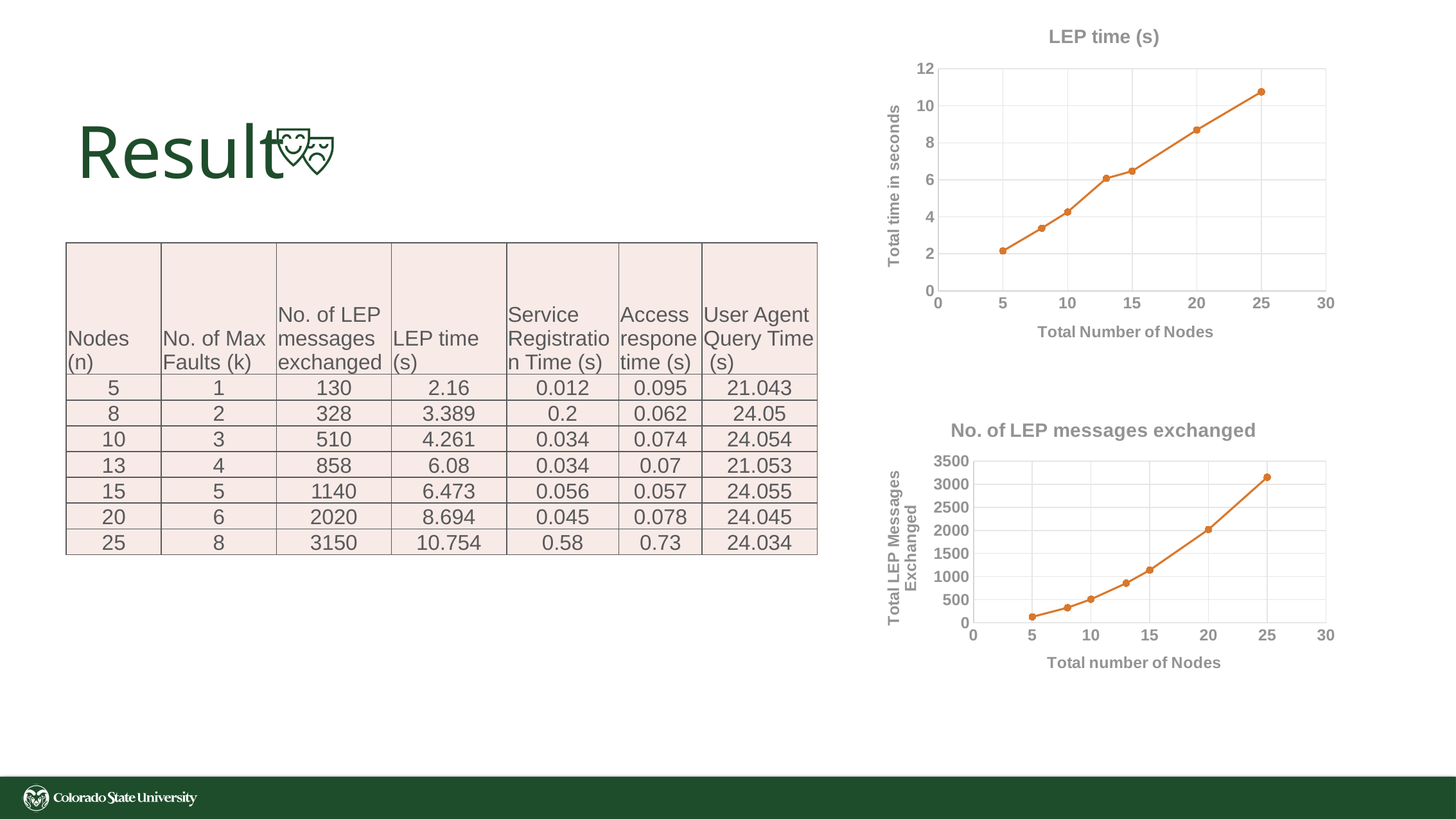
What kind of chart is the 'LEP time (s)' chart? line chart In the 'No. of LEP messages exchanged' chart, is the value at 15 nodes greater or less than 1500? less In the 'LEP time (s)' chart, at which number of nodes is the total time highest? 25 In the 'LEP time (s)' chart, is the value at 25 nodes greater or less than 10? greater In the 'No. of LEP messages exchanged' chart, do the messages exchanged rise or fall as the number of nodes increases? rise What is the y-axis title of the 'LEP time (s)' chart? Total time in seconds In the 'LEP time (s)' chart, does the total time rise or fall as the number of nodes increases? rise In the 'No. of LEP messages exchanged' chart, how many data points are plotted? 7 In the 'LEP time (s)' chart, how many data points are plotted? 7 In the 'No. of LEP messages exchanged' chart, at which number of nodes is the number of messages lowest? 5 What kind of chart is the 'No. of LEP messages exchanged' chart? line chart In the 'LEP time (s)' chart, which has the larger value: 20 nodes or 10 nodes? 20 nodes